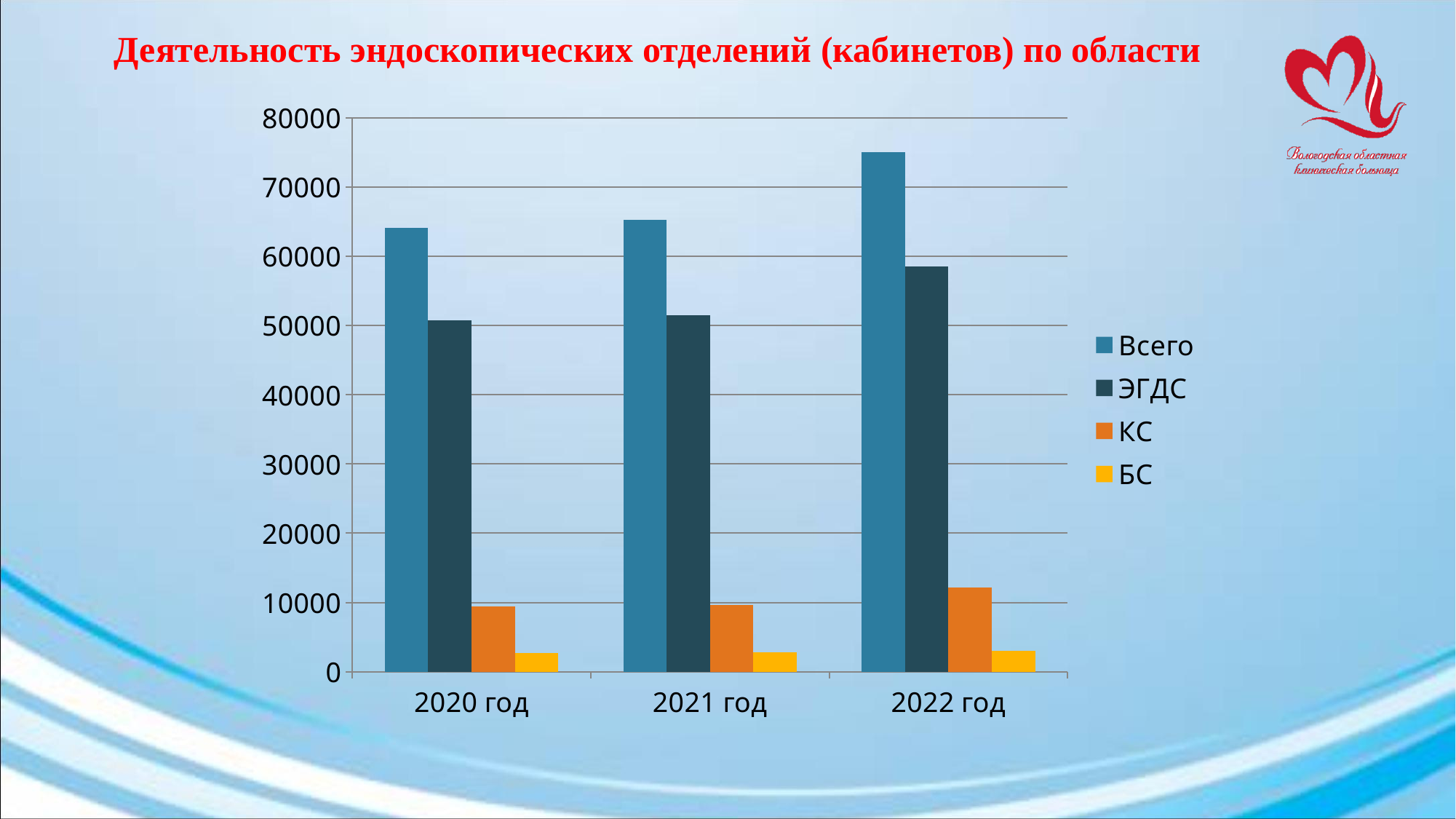
What is the title of the slide? Деятельность эндоскопических отделений (кабинетов) по области Which is larger in 2022 год: Всего or ЭГДС? Всего In which year is the value for Всего the highest? 2022 год In which year is the value for ЭГДС the lowest? 2020 год How many series does the legend list? 4 Is the value for КС in 2022 год greater or less than 10000? greater Does the value for Всего rise or fall from 2020 год to 2022 год? rise Is the value for ЭГДС in 2022 год greater or less than 60000? less Is the value for Всего in 2022 год greater or less than 70000? greater What kind of chart is shown on the slide? bar chart How many year categories are shown on the x axis? 3